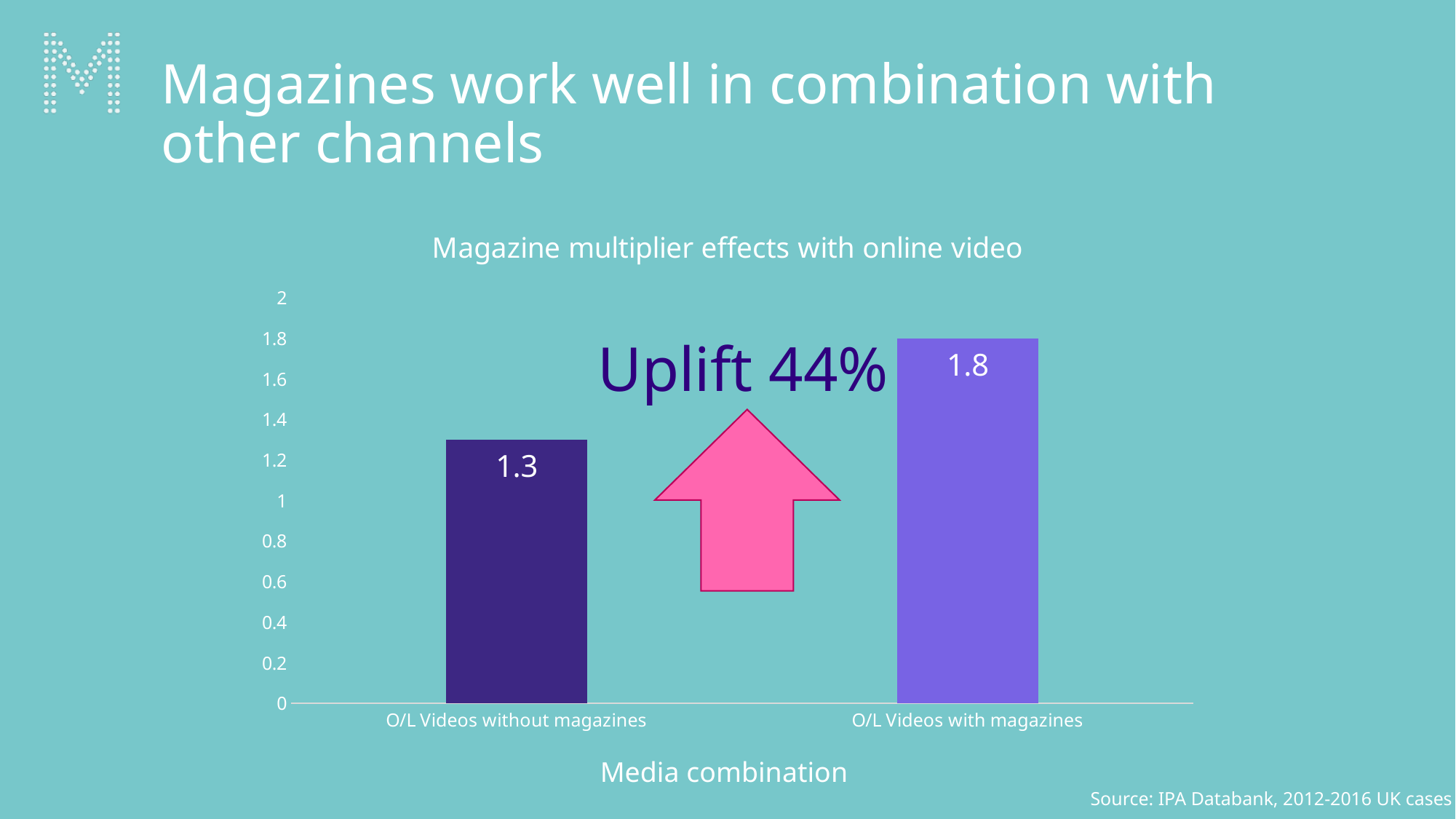
Is the value for O/L Videos without magazines greater or less than 1? greater What is the value for O/L Videos with magazines? 1.8 How many categories are shown on the chart? 2 What is the difference between the values for O/L Videos with magazines and O/L Videos without magazines? 0.5 What kind of chart is shown on the slide? Bar chart Is the value for O/L Videos with magazines greater or less than 2? less What is the title of the chart? Magazine multiplier effects with online video What is the value for O/L Videos without magazines? 1.3 Which category has the highest value? O/L Videos with magazines What uplift percentage is annotated on the chart? 44% Which category has the lowest value? O/L Videos without magazines Which is larger: the value for O/L Videos with magazines or O/L Videos without magazines? O/L Videos with magazines